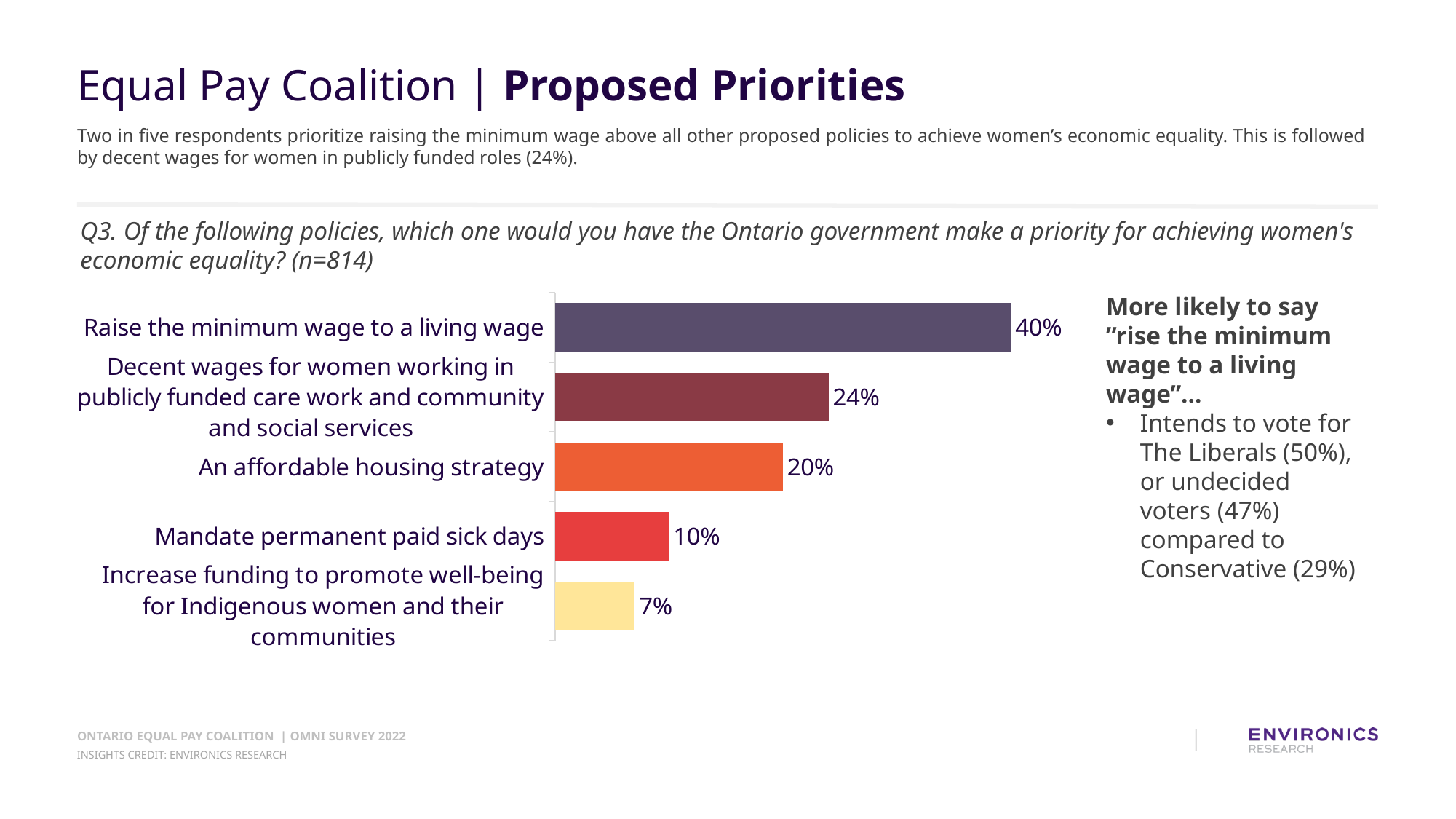
What is the value for "Increase funding to promote well-being for Indigenous women and their communities"? 7% What is the sample size (n) stated for Q3? 814 What percentage of respondents chose "Raise the minimum wage to a living wage" as the priority? 40% What is the value shown for "An affordable housing strategy"? 20% What percentage chose "Mandate permanent paid sick days"? 10% What is the difference in percentage points between "Raise the minimum wage to a living wage" and "Decent wages for women working in publicly funded care work and community and social services"? 16 percentage points What is the difference between the values for "Mandate permanent paid sick days" and "Increase funding to promote well-being for Indigenous women and their communities"? 3 percentage points What type of chart is used on this slide? Bar chart Which has a larger value: "An affordable housing strategy" or "Mandate permanent paid sick days"? An affordable housing strategy Which policy has the highest share of respondents? Raise the minimum wage to a living wage How many policy categories are shown in the bar chart? 5 Which policy has the lowest share of respondents? Increase funding to promote well-being for Indigenous women and their communities